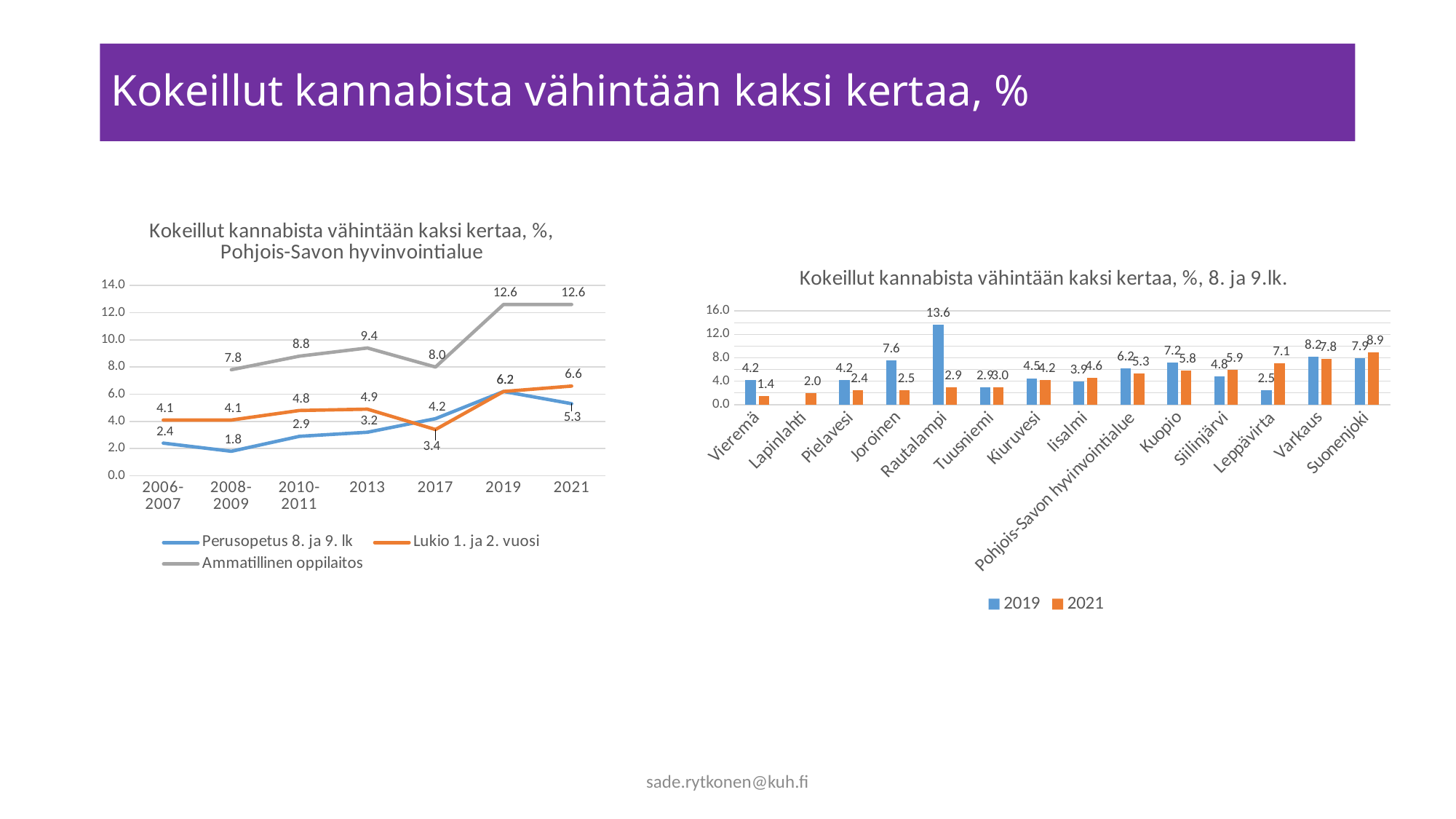
In the right chart (8. ja 9.lk.), what is the difference between the 2019 and 2021 values for Rautalampi? 10.7 In the left chart (Pohjois-Savon hyvinvointialue), how many series does the legend list? 3 In the left chart (Pohjois-Savon hyvinvointialue), what kind of chart is it? Line chart In the right chart (8. ja 9.lk.), which municipality has the highest 2019 value? Rautalampi In the left chart (Pohjois-Savon hyvinvointialue), what is the difference between the Lukio 1. ja 2. vuosi value in 2021 and in 2019? 0.4 In the left chart (Pohjois-Savon hyvinvointialue), what is the value for Ammatillinen oppilaitos in 2019? 12.6 In the left chart (Pohjois-Savon hyvinvointialue), what is the value for Lukio 1. ja 2. vuosi in 2017? 3.4 In the right chart (8. ja 9.lk.), which is larger for Suonenjoki, the 2019 value or the 2021 value? 2021 In the right chart (8. ja 9.lk.), which has the lowest 2021 value? Vieremä In the right chart (8. ja 9.lk.), what is the 2021 value for Leppävirta? 7.1 In the right chart (8. ja 9.lk.), how many series does the legend list? 2 In the left chart (Pohjois-Savon hyvinvointialue), what is the value for Perusopetus 8. ja 9. lk in 2021? 5.3